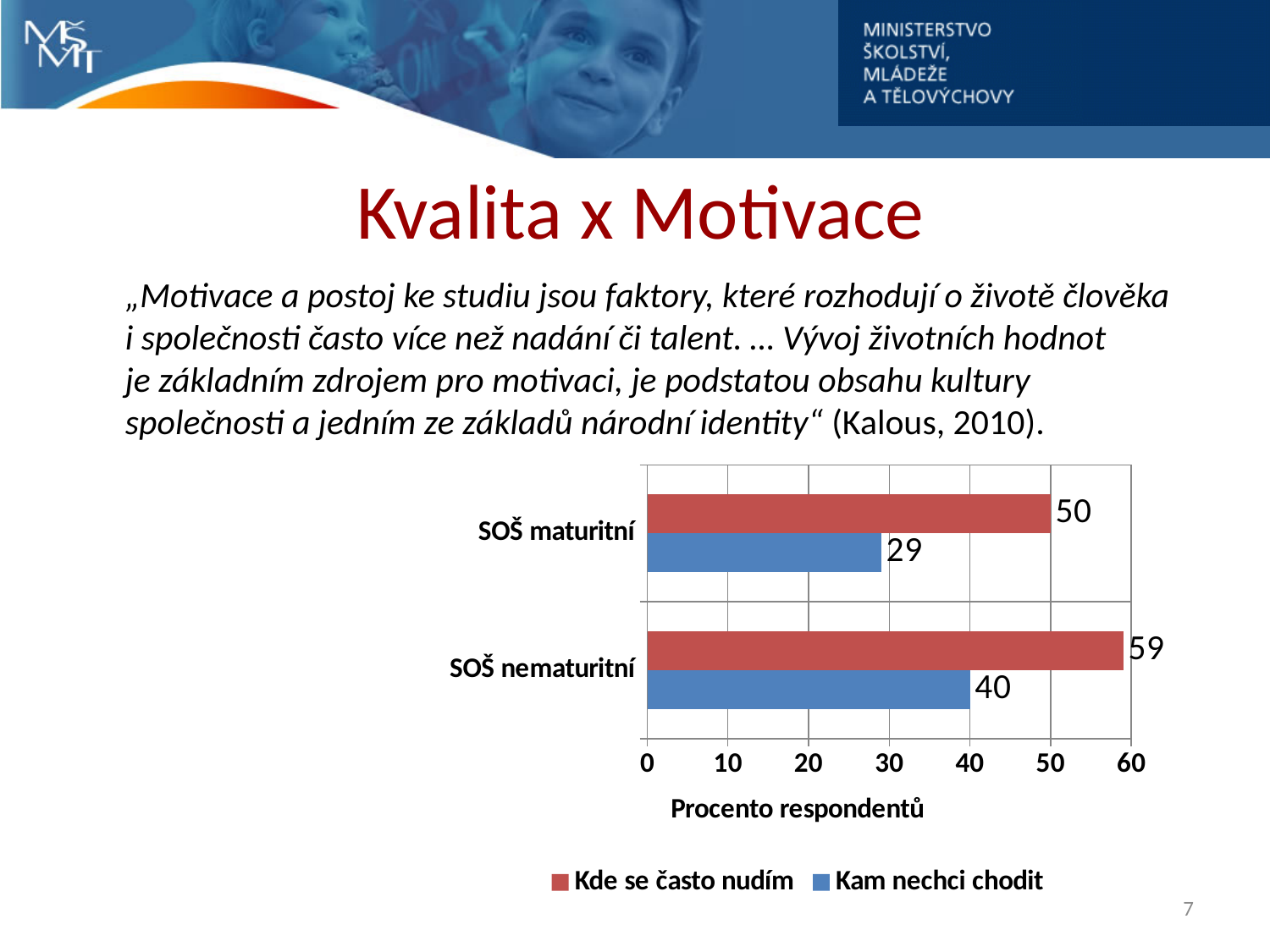
How many categories are shown on the chart? 2 What kind of chart is shown on the slide? Bar chart What is the value for 'Kam nechci chodit' for SOŠ maturitní? 29 What is the value for 'Kde se často nudím' for SOŠ maturitní? 50 What is the difference between the 'Kde se často nudím' values for SOŠ nematuritní and SOŠ maturitní? 9 What is the label of the horizontal axis of the chart? Procento respondentů What is the value for 'Kam nechci chodit' for SOŠ nematuritní? 40 How many series does the legend list? 2 Which category has the highest value for 'Kde se často nudím'? SOŠ nematuritní Which is larger: 'Kam nechci chodit' for SOŠ nematuritní or 'Kde se často nudím' for SOŠ maturitní? Kde se často nudím for SOŠ maturitní Which category has the lowest value for 'Kam nechci chodit'? SOŠ maturitní What is the difference between 'Kde se často nudím' and 'Kam nechci chodit' for SOŠ nematuritní? 19